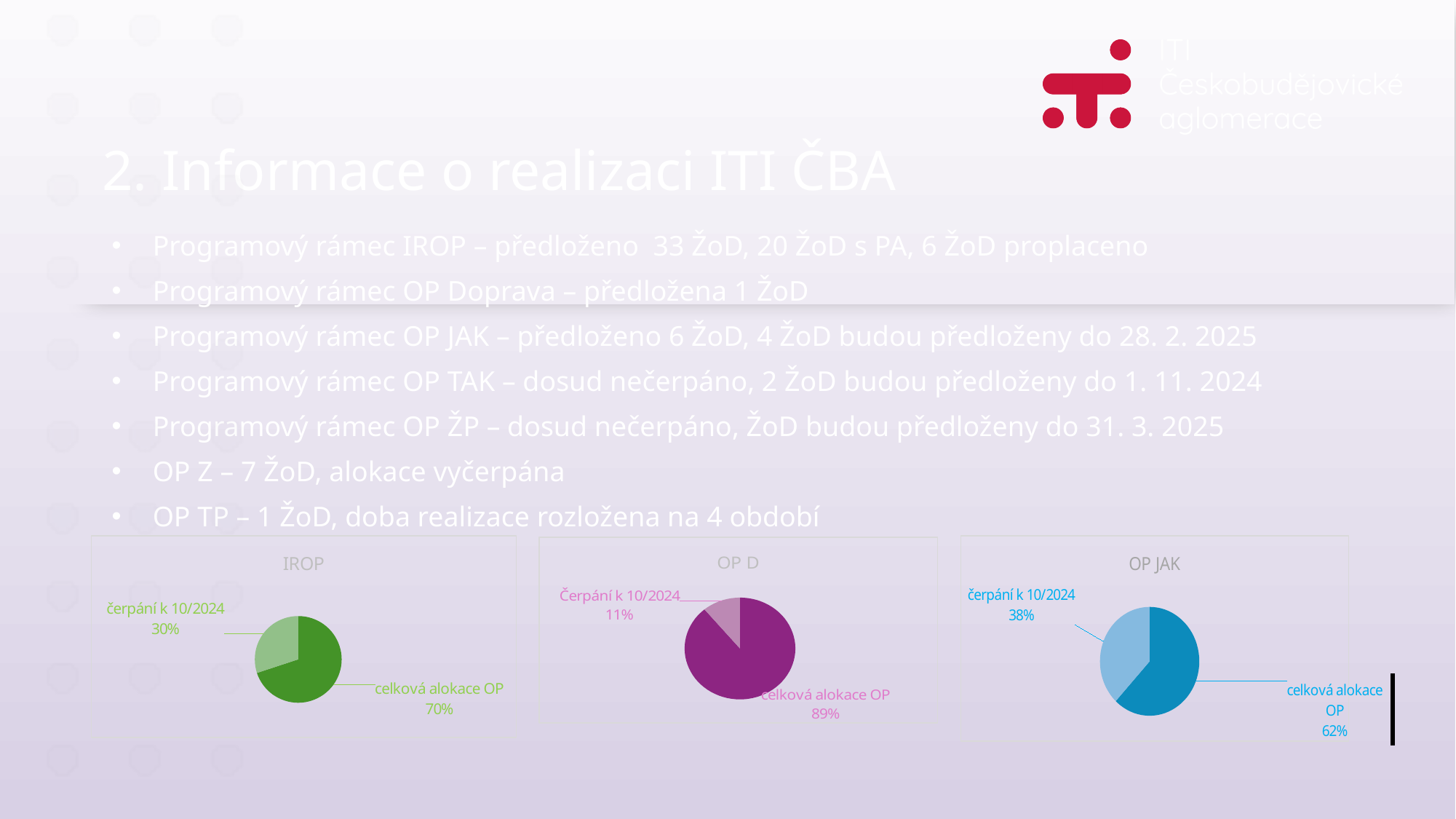
In the OP JAK chart, what share is labelled "čerpání k 10/2024"? 38% How many slices does the OP D chart have? 2 In the IROP chart, what share is labelled "celková alokace OP"? 70% In the OP JAK chart, which slice is larger, "čerpání k 10/2024" or "celková alokace OP"? celková alokace OP How many pie charts are shown on the slide? 3 In the IROP chart, what share is labelled "čerpání k 10/2024"? 30% In the IROP chart, what is the difference between the "celková alokace OP" share and the "čerpání k 10/2024" share? 40% What kind of chart is the IROP chart? Pie chart Which of the three charts shows the smallest "čerpání k 10/2024" share? OP D